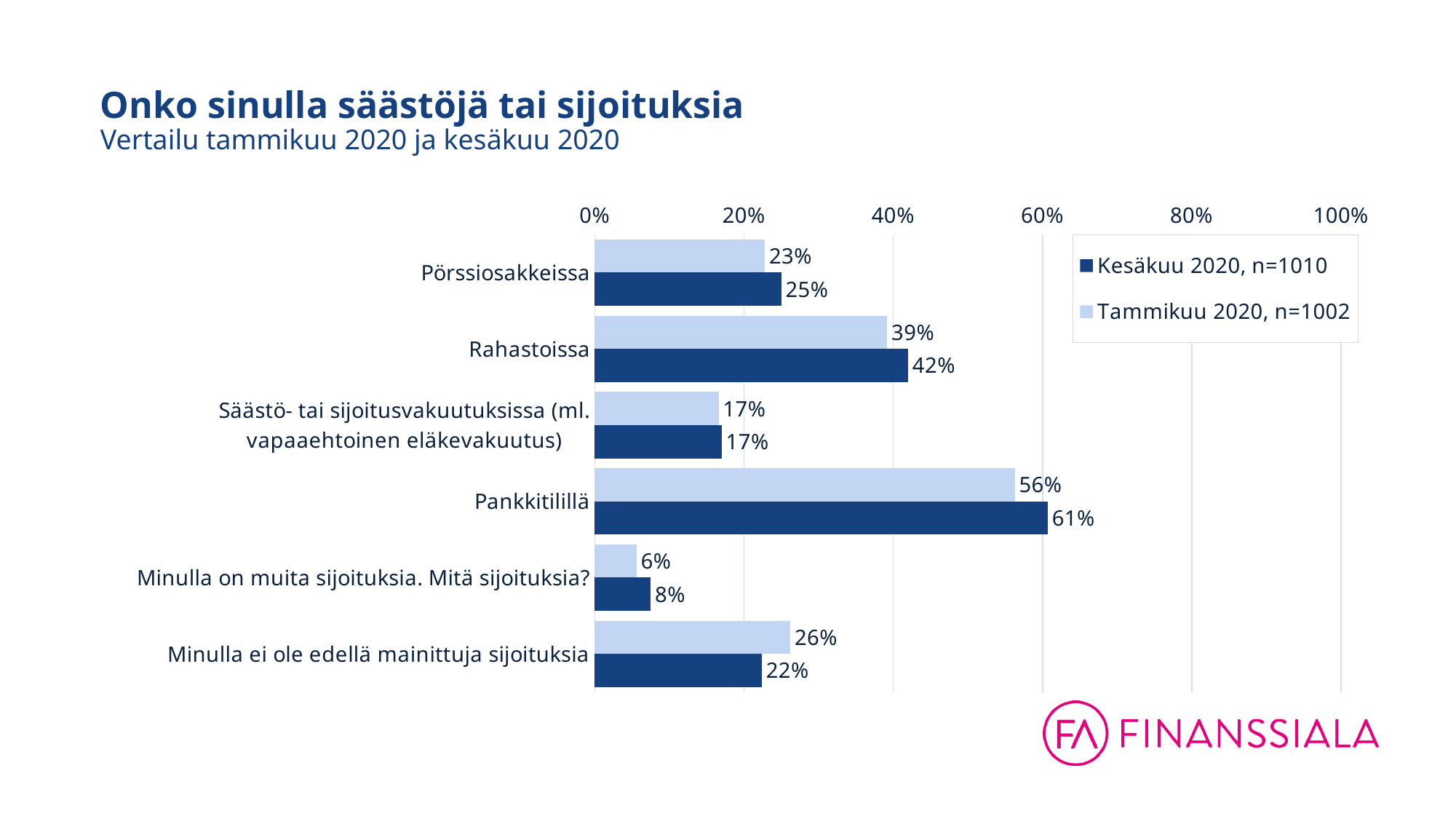
How many series does the legend list? 2 What is the value for Rahastoissa in the Tammikuu 2020, n=1002 series? 39% What kind of chart is shown on the slide? bar chart How many categories are shown on the chart? 6 What is the value for Pankkitilillä in the Kesäkuu 2020, n=1010 series? 61% Which category has the highest value in the Kesäkuu 2020, n=1010 series? Pankkitilillä For Rahastoissa, which series has the larger value, Kesäkuu 2020 or Tammikuu 2020? Kesäkuu 2020 Is the Kesäkuu 2020 value for Pankkitilillä greater or less than 60%? greater What is the difference between the Tammikuu 2020 and Kesäkuu 2020 values for Minulla ei ole edellä mainittuja sijoituksia? 4% What is the difference between the Kesäkuu 2020 and Tammikuu 2020 values for Pankkitilillä? 5% What is the value for Minulla ei ole edellä mainittuja sijoituksia in the Kesäkuu 2020, n=1010 series? 22% Which category has the lowest value in the Tammikuu 2020, n=1002 series? Minulla on muita sijoituksia. Mitä sijoituksia?